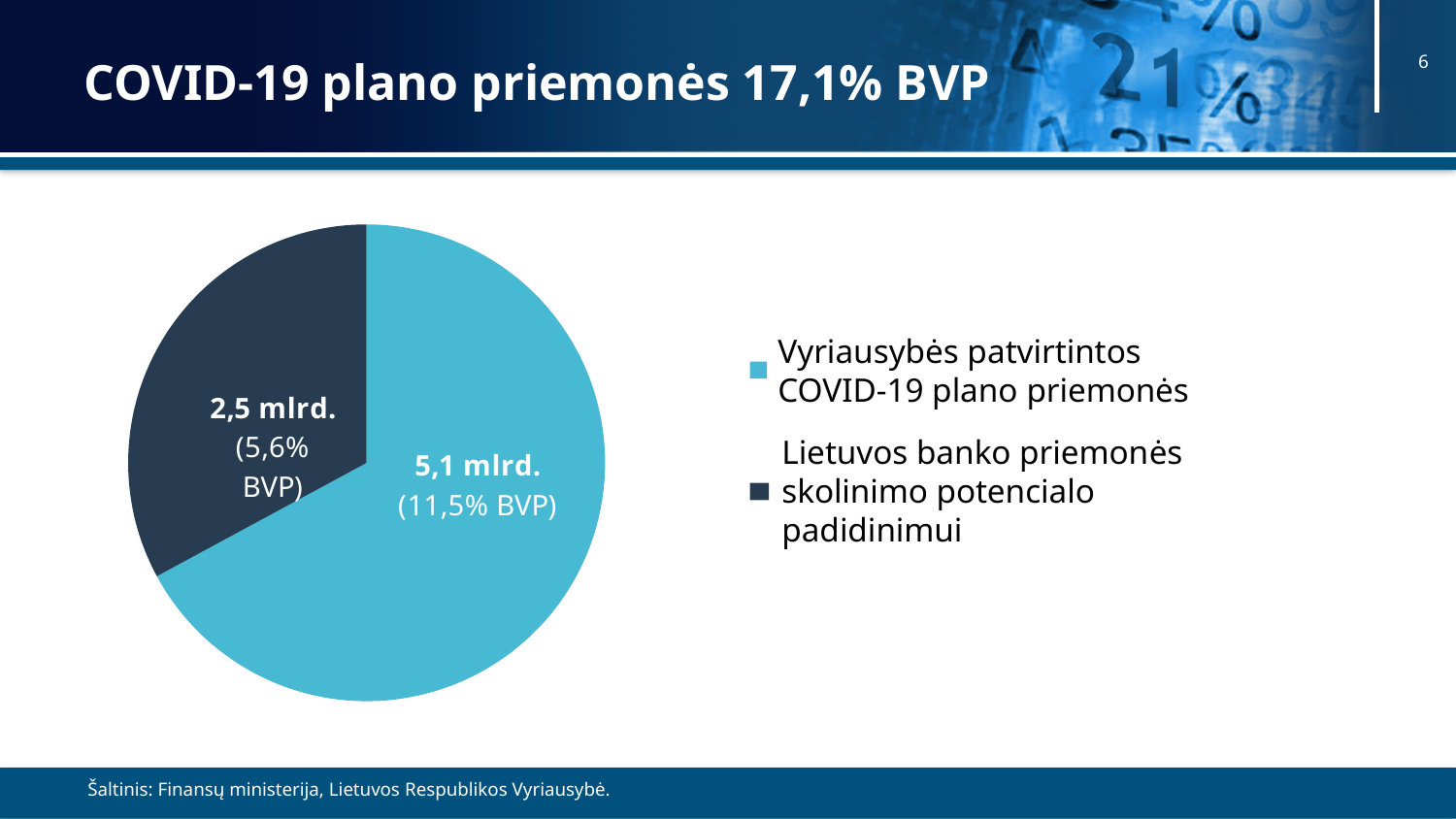
What is the value shown for Vyriausybės patvirtintos COVID-19 plano priemonės? 5,1 mlrd. What kind of chart is shown on the slide? pie chart How many entries does the legend list? 2 What percentage of BVP is shown for the Lietuvos banko priemonės skolinimo potencialo padidinimui slice? 5,6% BVP Which slice of the pie chart is the smallest? Lietuvos banko priemonės skolinimo potencialo padidinimui What percentage of BVP is shown for the Vyriausybės patvirtintos COVID-19 plano priemonės slice? 11,5% BVP What is the total of the two slices in mlrd.? 7,6 mlrd. How many slices does the pie chart have? 2 What is the difference in mlrd. between the Vyriausybės patvirtintos COVID-19 plano priemonės slice and the Lietuvos banko priemonės slice? 2,6 mlrd. Which colour represents Lietuvos banko priemonės skolinimo potencialo padidinimui in the pie chart? dark blue What is the value shown for Lietuvos banko priemonės skolinimo potencialo padidinimui? 2,5 mlrd. Which slice of the pie chart is the largest? Vyriausybės patvirtintos COVID-19 plano priemonės